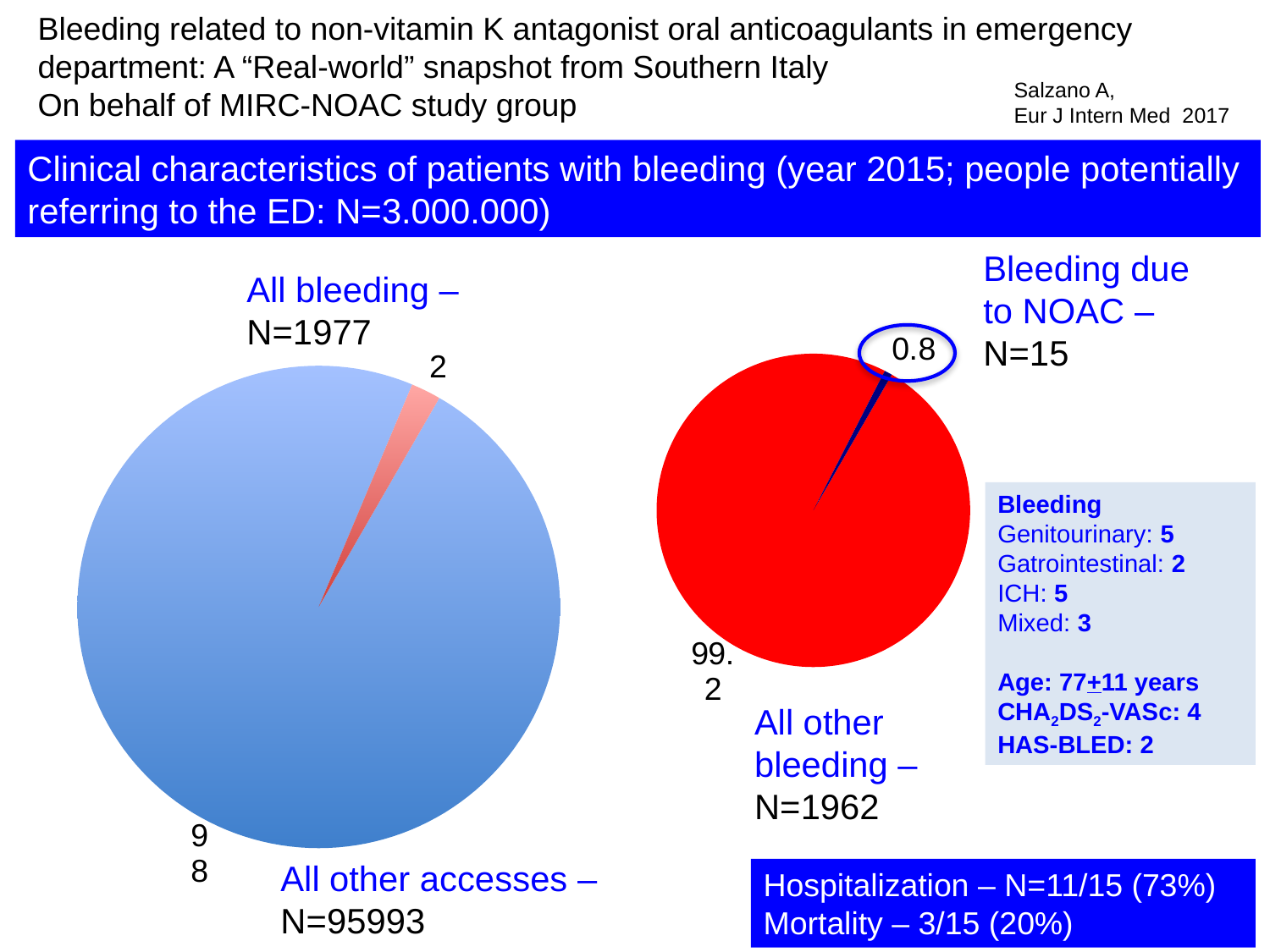
In the left pie chart, which slice is the largest? All other accesses In the left pie chart, what value is labelled on the 'All bleeding' slice? 2 In the left pie chart, what is the difference between the labelled values of the 'All other accesses' slice and the 'All bleeding' slice? 96 In the right pie chart, what colour is the 'All other bleeding' slice? red What type of chart is the right chart on the slide? pie chart In the right pie chart, what value is labelled on the 'Bleeding due to NOAC' slice? 0.8 In the right pie chart, which slice is the smallest? Bleeding due to NOAC In the right pie chart, what value is labelled on the 'All other bleeding' slice? 99.2 What type of chart is the left chart on the slide? pie chart How many slices does the right pie chart have? 2 In the left pie chart, what value is labelled on the 'All other accesses' slice? 98 How many slices does the left pie chart have? 2